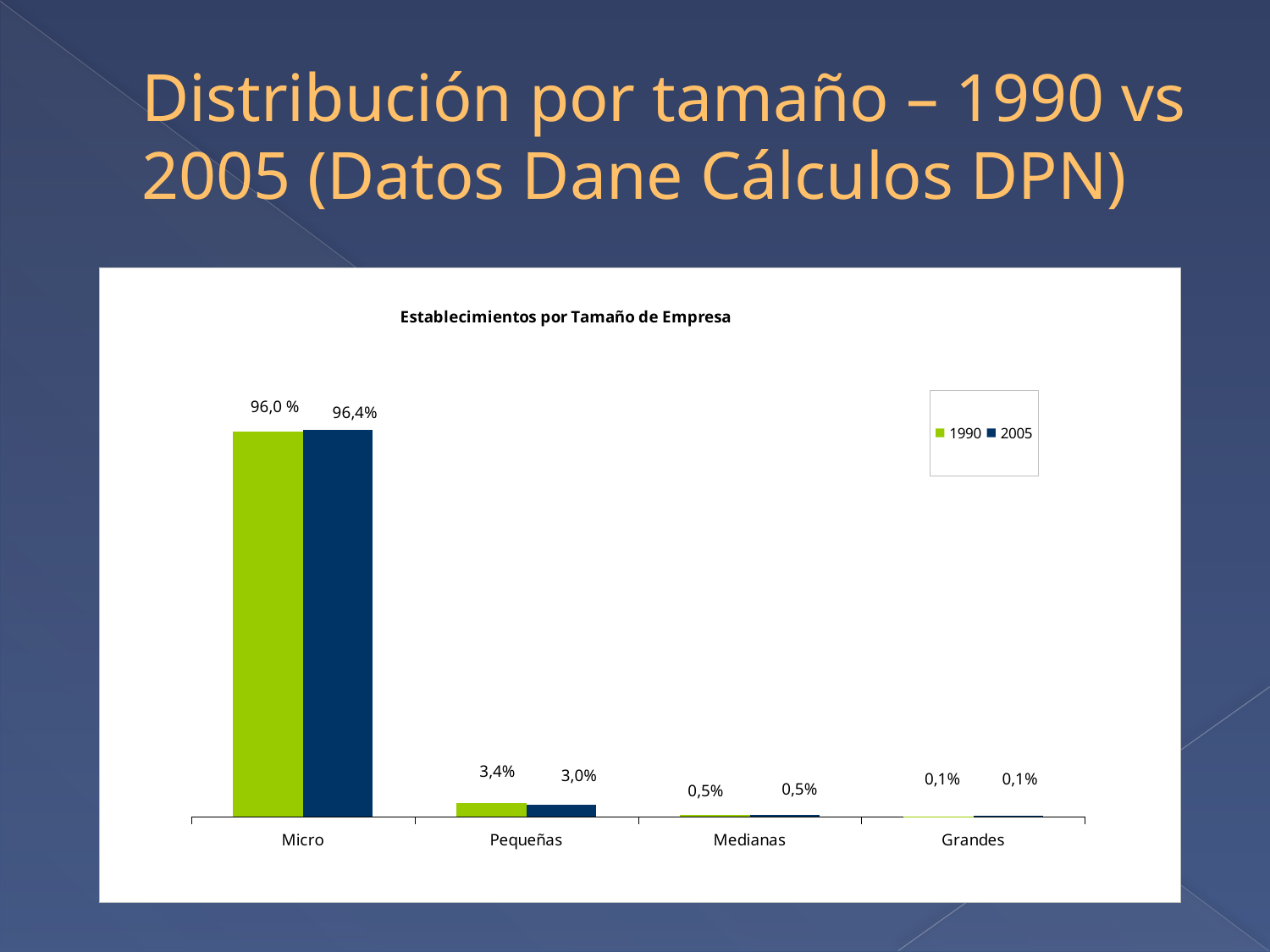
Which category has the lowest value in the 1990 series? Grandes What is the value for Micro in the 2005 series? 96,4% How many categories are shown on the x axis? 4 What is the value for Micro in the 1990 series? 96,0 % Which is larger for Micro: the 1990 value or the 2005 value? 2005 How many series does the legend list? 2 What is the value for Pequeñas in the 2005 series? 3,0% What is the value for Grandes in the 1990 series? 0,1% What is the value for Medianas in the 2005 series? 0,5% Which category has the highest value in the 2005 series? Micro What is the value for Pequeñas in the 1990 series? 3,4% What is the difference between the 1990 and 2005 values for Pequeñas? 0,4%